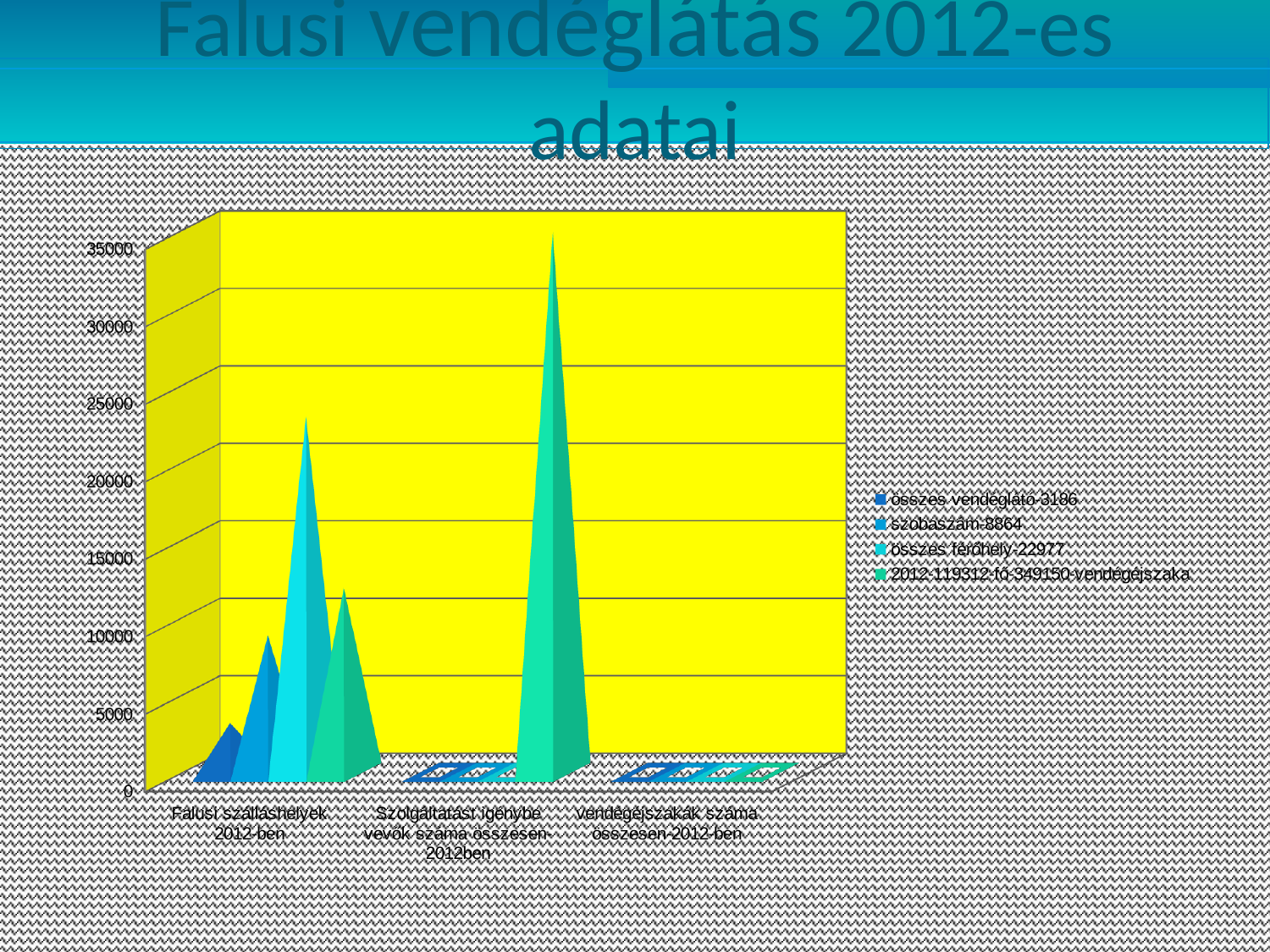
In the category 'Falusi szálláshelyek 2012-ben', which is larger: 'összes férőhely-22977' or 'szobaszám-8864'? összes férőhely-22977 How many series does the legend list? 4 Is the tallest bar in the category 'Szolgáltatást igénybe vevők száma összesen-2012ben' greater or less than 30000? greater Which category has the tallest bar in the chart? Szolgáltatást igénybe vevők száma összesen-2012ben In the category 'Falusi szálláshelyek 2012-ben', is the value for 'összes férőhely-22977' greater or less than 20000? greater In the category 'Falusi szálláshelyek 2012-ben', is the value for 'összes vendéglátó-3186' greater or less than 10000? less How many categories are shown along the x axis? 3 What is the third entry listed in the legend? összes férőhely-22977 What is the title of the slide's chart? Falusi vendéglátás 2012-es adatai What kind of chart is shown on the slide? bar chart Which category shows the lowest values overall? vendégéjszakák száma összesen-2012-ben